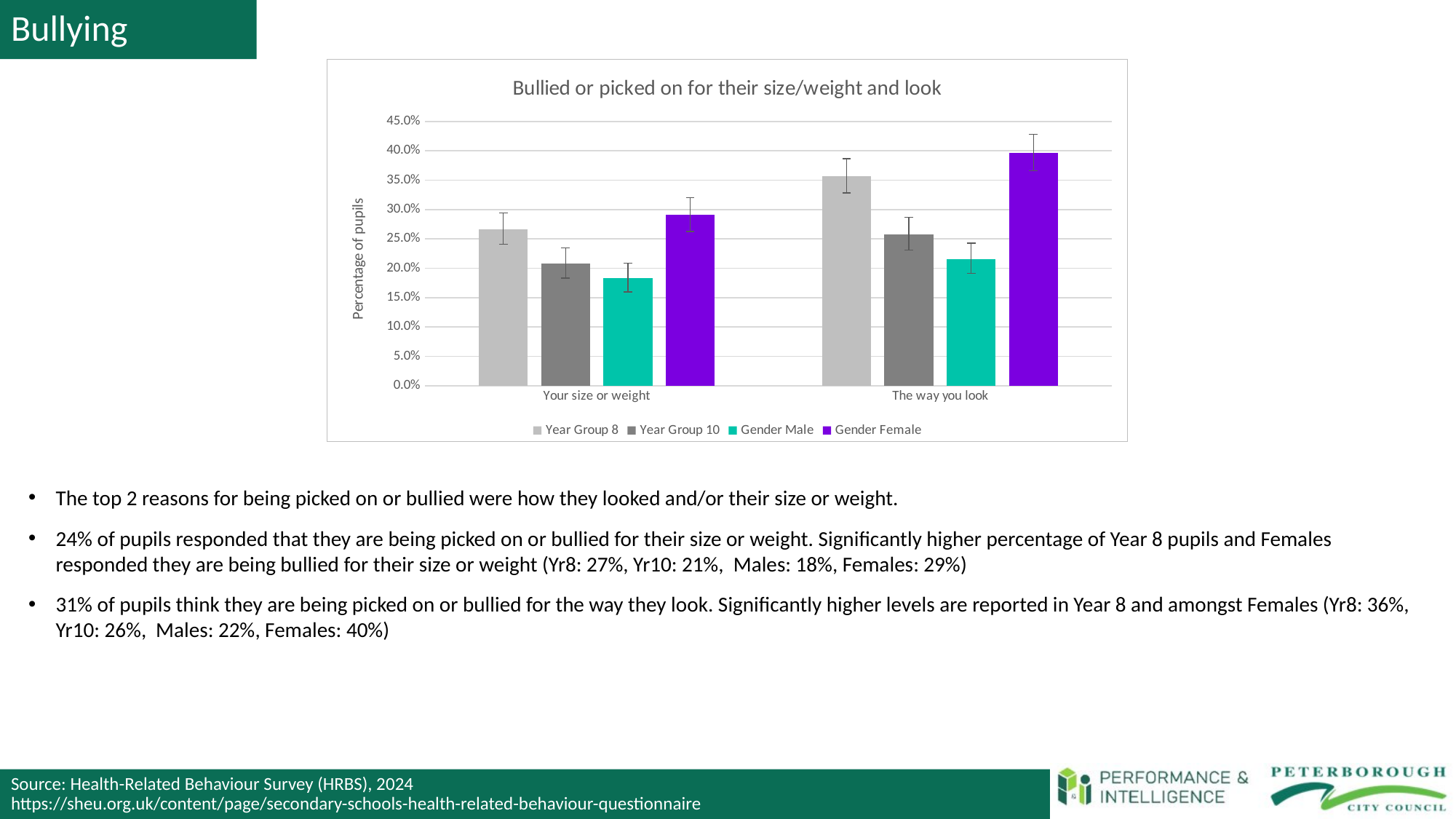
Which series has the highest bar for 'The way you look'? Gender Female Is the value for Gender Male under 'Your size or weight' greater or less than 20.0%? less Does each series rise or fall from 'Your size or weight' to 'The way you look'? rise How many categories are shown on the x axis of the chart? 2 What is the title of the chart? Bullied or picked on for their size/weight and look How many series does the chart legend list? 4 Is the value for Year Group 8 under 'The way you look' greater or less than 30.0%? greater Is the value for Gender Female under 'The way you look' greater or less than 35.0%? greater For 'The way you look', which is larger: Gender Female or Gender Male? Gender Female For 'Your size or weight', which is larger: Year Group 8 or Year Group 10? Year Group 8 Which series has the lowest bar for 'Your size or weight'? Gender Male What kind of chart is shown on the slide? bar chart